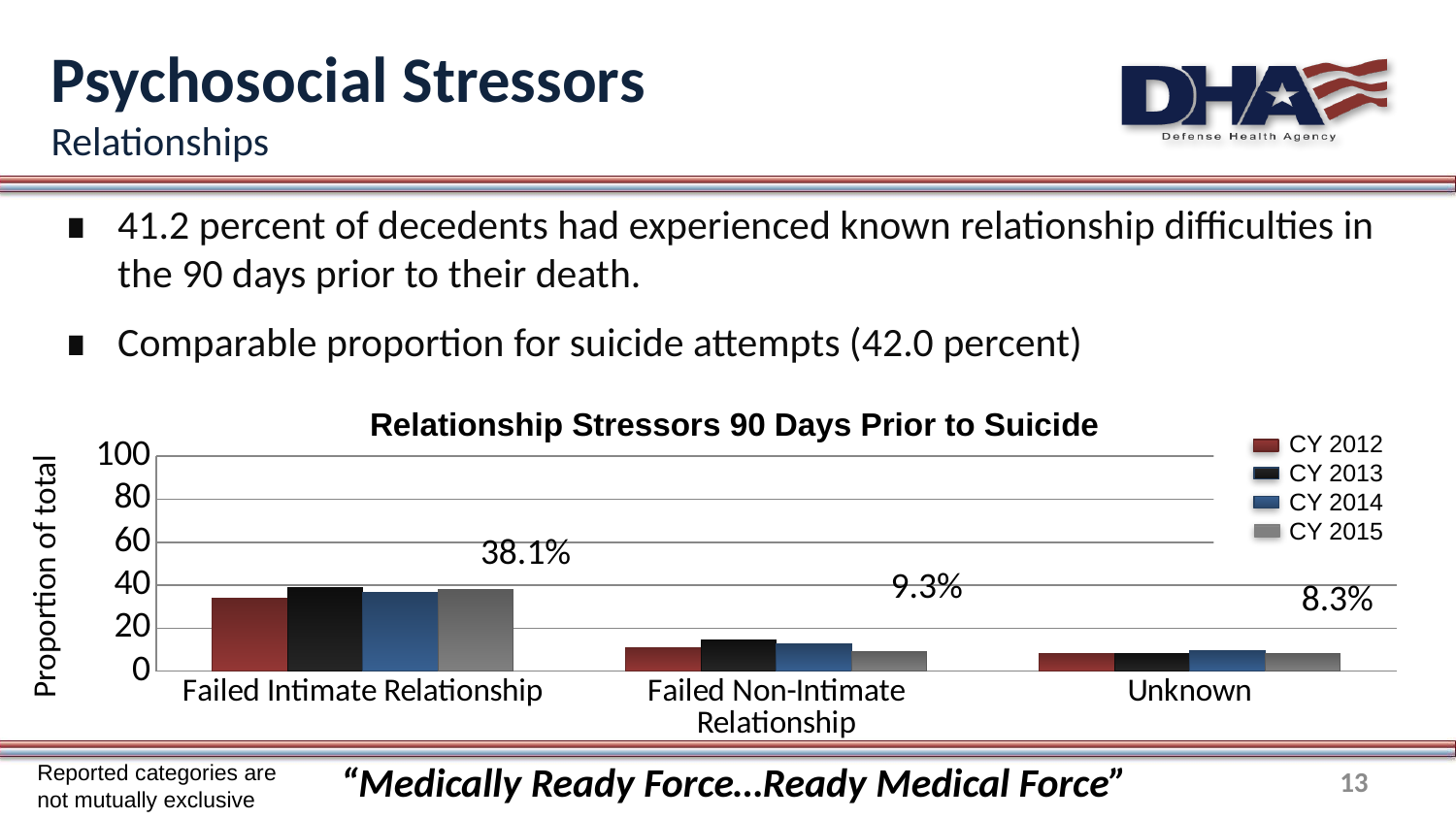
For CY 2015, which is larger: Failed Non-Intimate Relationship or Unknown? Failed Non-Intimate Relationship Is the CY 2013 value for Failed Non-Intimate Relationship greater or less than 20? less What is the title of the chart's y axis? Proportion of total What is the difference between the CY 2015 values for Failed Intimate Relationship and Failed Non-Intimate Relationship? 28.8 percentage points How many categories are shown on the x axis of the chart? 3 What kind of chart is shown on the slide? Bar chart What is the CY 2015 value for Failed Intimate Relationship? 38.1% Is the CY 2012 value for Failed Intimate Relationship greater or less than 40? less Which category has the highest values across all years? Failed Intimate Relationship What is the CY 2015 value for Unknown? 8.3% How many series does the legend of the chart list? 4 What is the CY 2015 value for Failed Non-Intimate Relationship? 9.3%